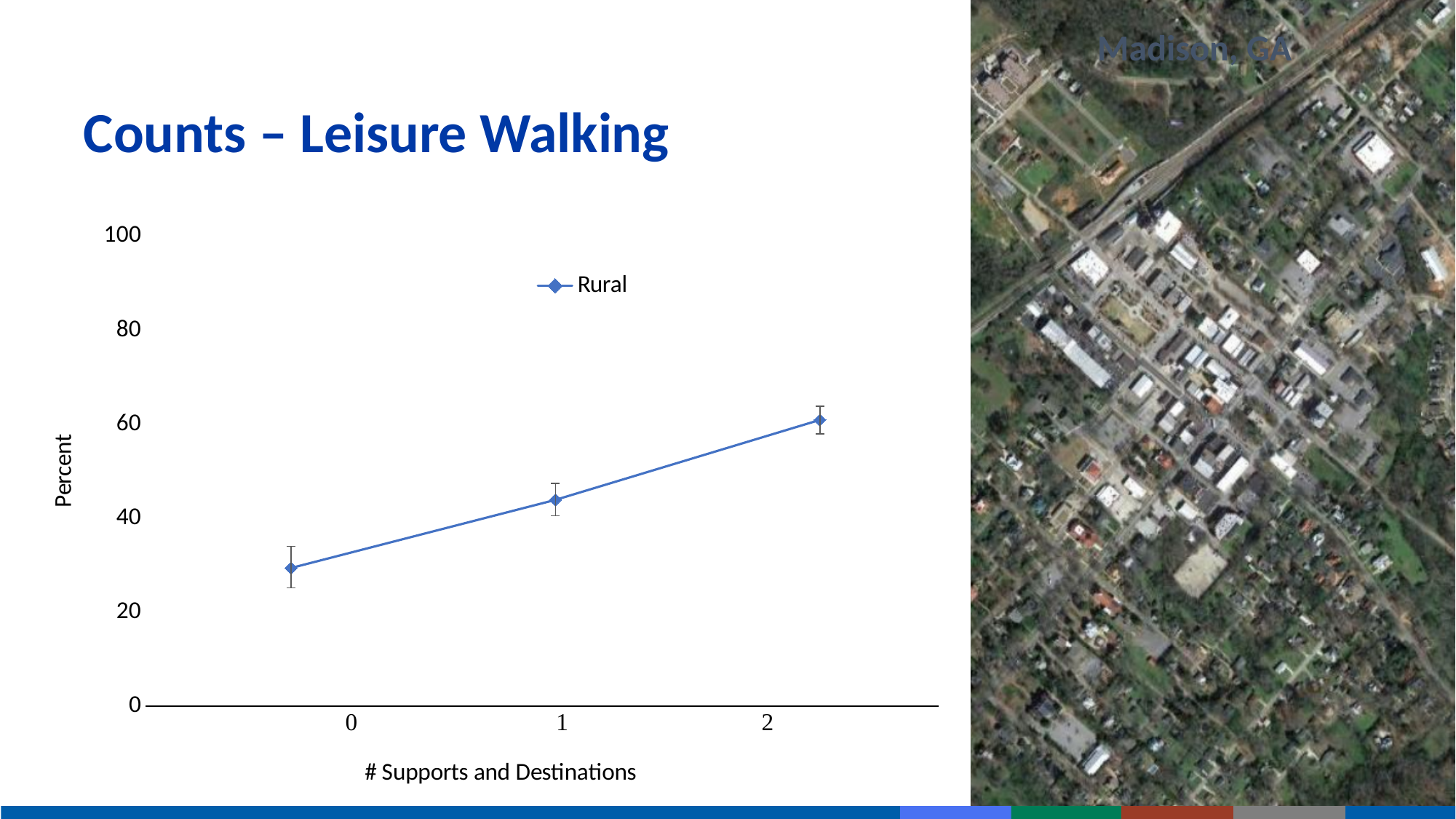
At which number of supports and destinations is the percent highest? 2 What kind of chart is shown on the slide? line chart What is the label of the x axis? # Supports and Destinations Is the percent value at 0 supports and destinations greater or less than 40? less How many data points are plotted on the Rural line? 3 Which has a higher percent: 1 support and destination or 2 supports and destinations? 2 How many series does the legend list? 1 Do the values rise or fall as the number of supports and destinations increases from 0 to 2? rise Is the percent value at 1 support and destination greater or less than 40? greater Is the percent value at 2 supports and destinations greater or less than 80? less At which number of supports and destinations is the percent lowest? 0 What is the name of the series shown in the legend? Rural